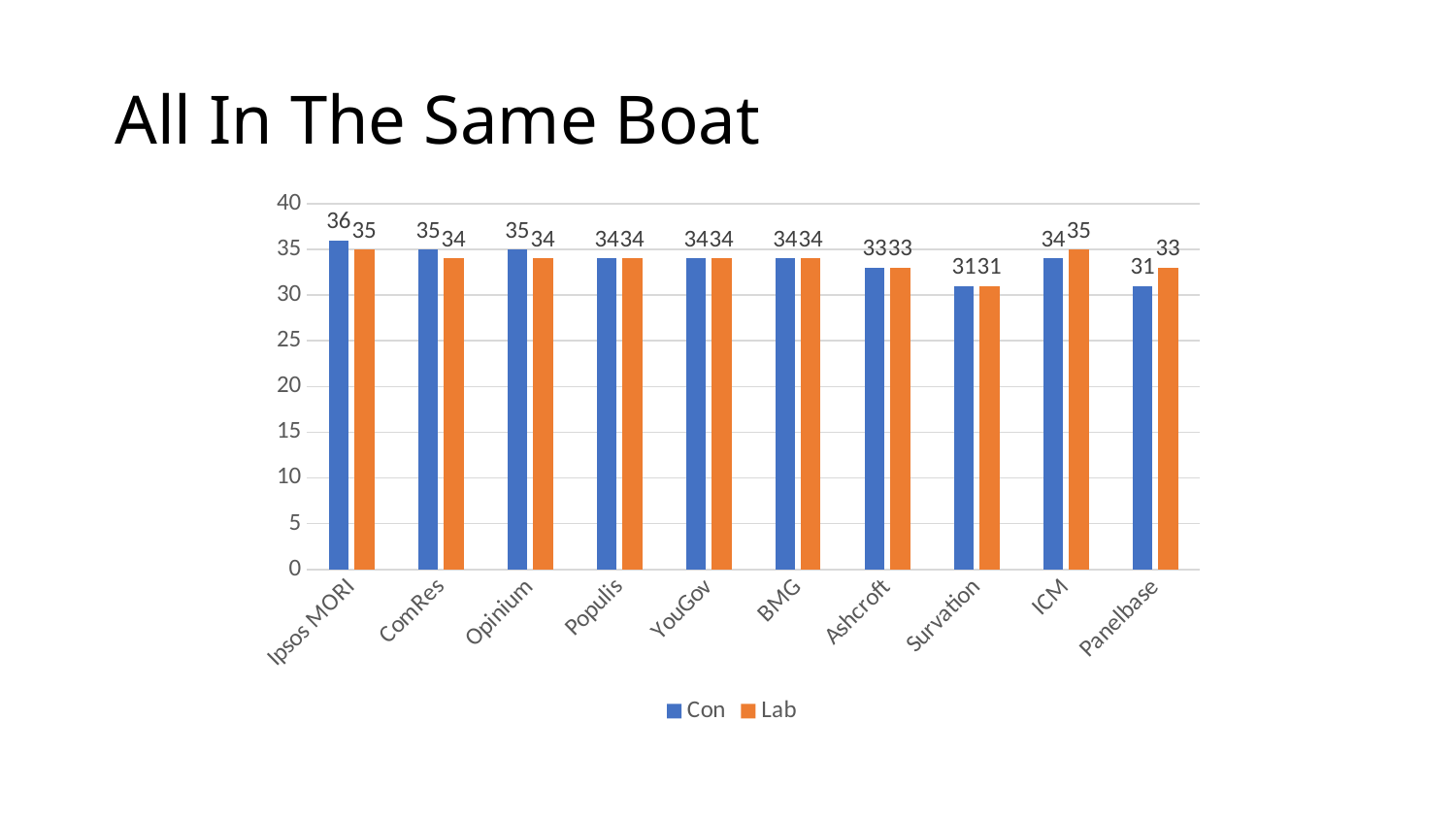
What is the Lab value for ICM? 35 What is the Lab value for Panelbase? 33 Which pollster has the lowest Lab value? Survation What is the Con value for Ipsos MORI? 36 What is the title of the slide? All In The Same Boat How many pollsters are shown on the x axis? 10 What kind of chart is shown on the slide? Bar chart Which pollster has the highest Con value? Ipsos MORI What is the Con value for Survation? 31 What is the difference between the Lab and Con values for Panelbase? 2 For Panelbase, which is larger, the Con value or the Lab value? Lab How many series does the legend list? 2